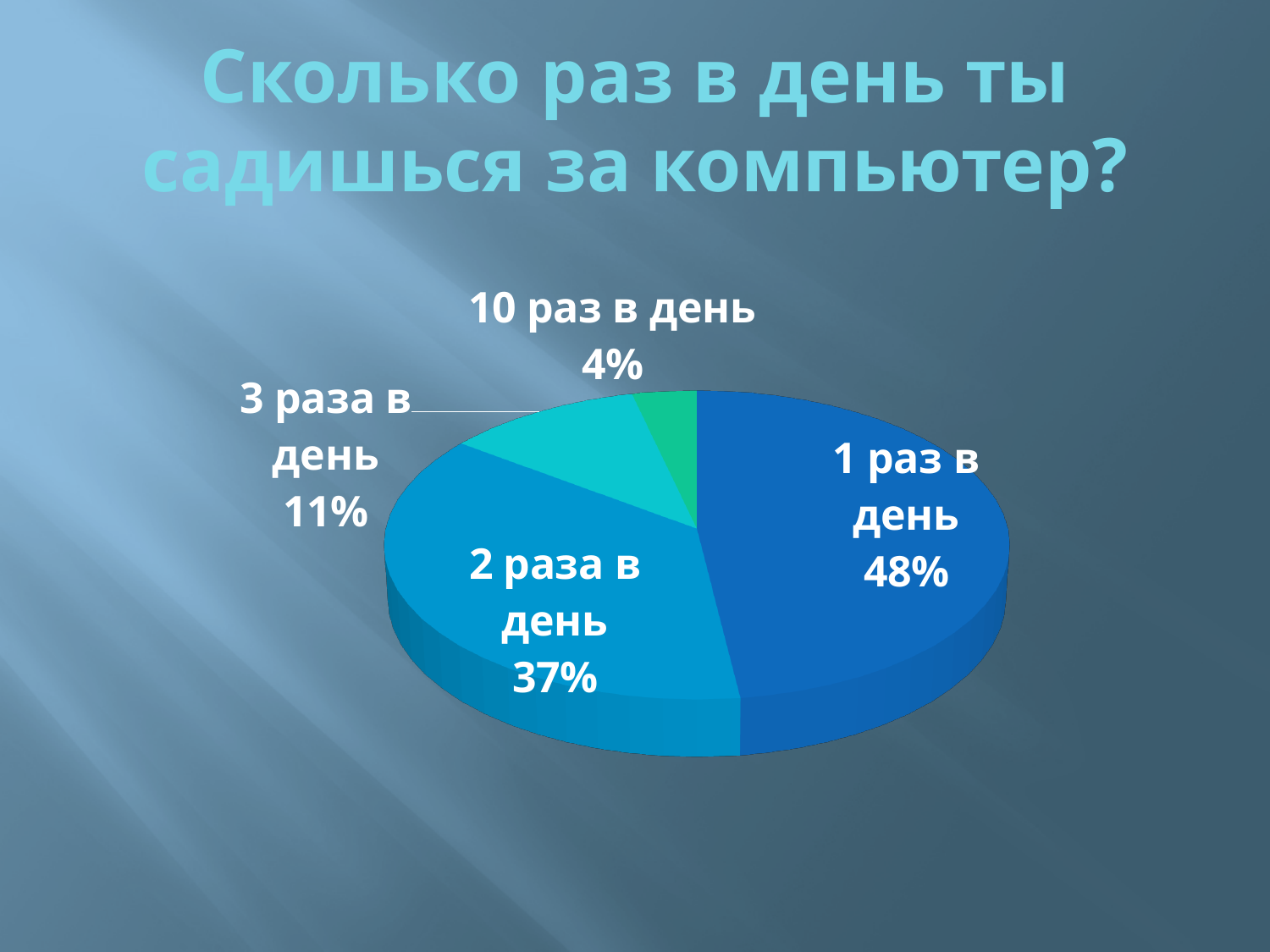
What share of the pie does "2 раза в день" take? 37% What is the difference in percentage points between "1 раз в день" and "2 раза в день"? 11% What kind of chart is shown on the slide? Pie chart What is the title of the slide? Сколько раз в день ты садишься за компьютер? What share of the pie does "3 раза в день" take? 11% What share of the pie does "10 раз в день" take? 4% What is the difference in percentage points between "3 раза в день" and "10 раз в день"? 7% How many categories are shown in the pie chart? 4 Which category has the smallest slice of the pie? 10 раз в день Which is larger, the slice for "2 раза в день" or the slice for "3 раза в день"? 2 раза в день Which category has the largest slice of the pie? 1 раз в день